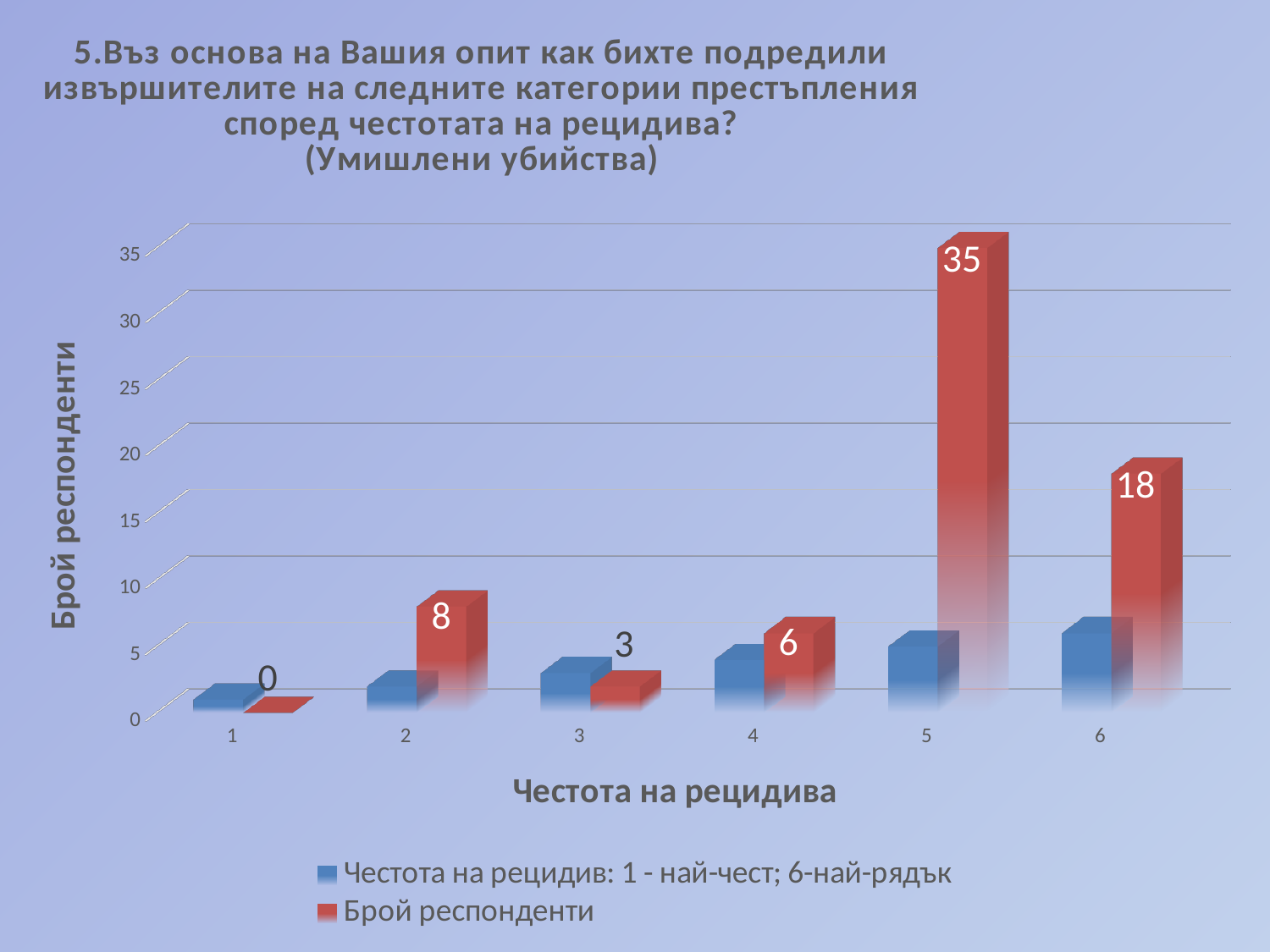
Which category has the highest value for Брой респонденти? 5 Which is larger, Брой респонденти for category 3 or for category 4? category 4 What is the label of the y axis? Брой респонденти What is the value of Брой респонденти for category 1? 0 How many categories are shown on the x axis? 6 Is the value of Брой респонденти for category 6 greater or less than 15? greater What is the difference between Брой респонденти for category 5 and category 6? 17 What kind of chart is shown on the slide? bar chart Which category has the lowest value for Брой респонденти? 1 What is the value of Брой респонденти for category 2? 8 How many series does the legend list? 2 What is the value of Брой респонденти for category 5? 35